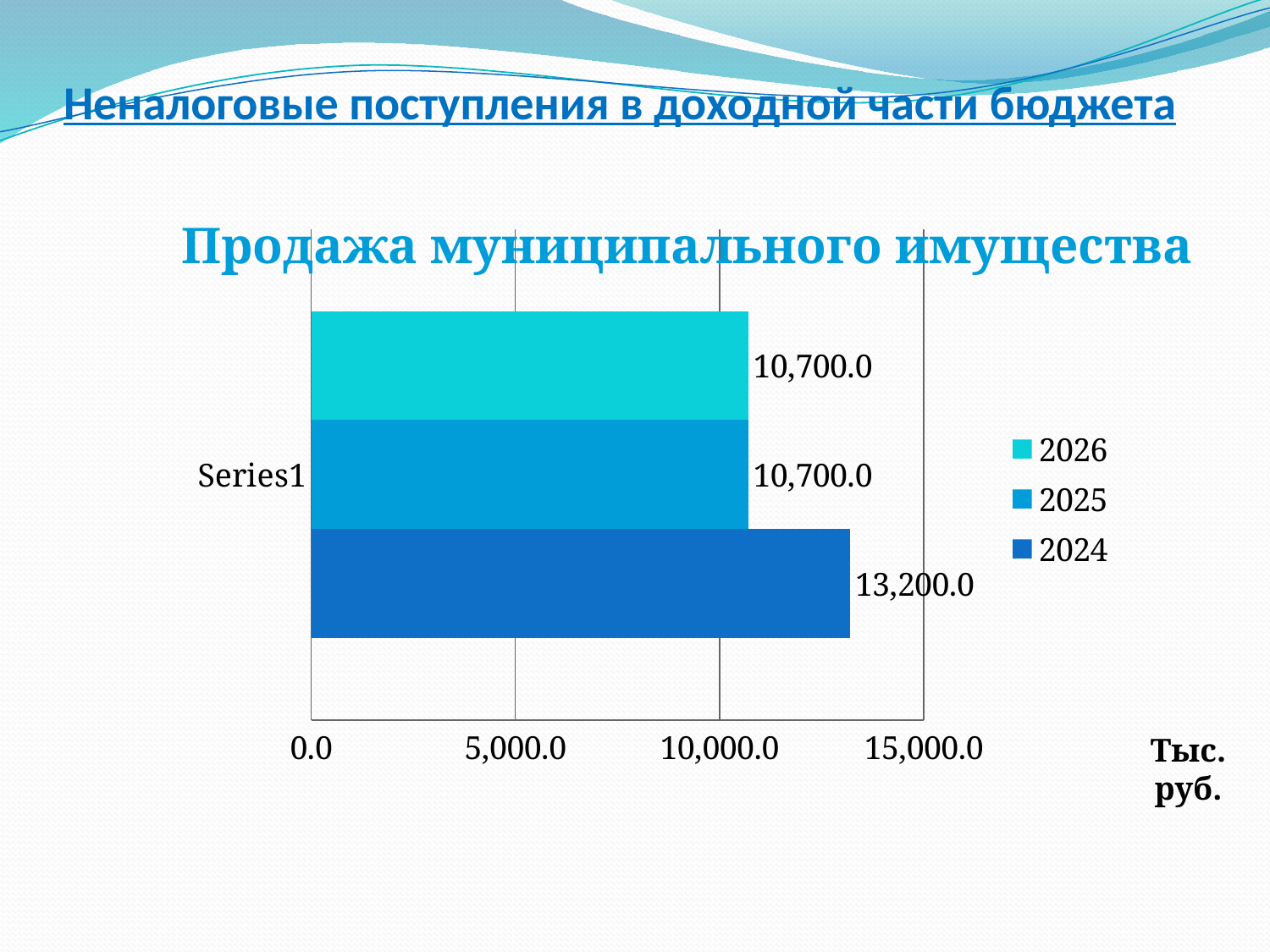
Is the value for 2024 greater or less than 10,000.0? greater What is the value for 2026? 10,700.0 What unit is shown next to the x axis? Тыс. руб. How many series does the legend list? 3 What kind of chart is shown? bar chart What is the title of the chart? Продажа муниципального имущества Which is larger, the value for 2024 or the value for 2026? 2024 Which year has the highest value? 2024 What is the value for 2025? 10,700.0 Is the value for 2025 greater or less than 15,000.0? less What is the value for 2024? 13,200.0 What is the difference between the values for 2024 and 2025? 2,500.0